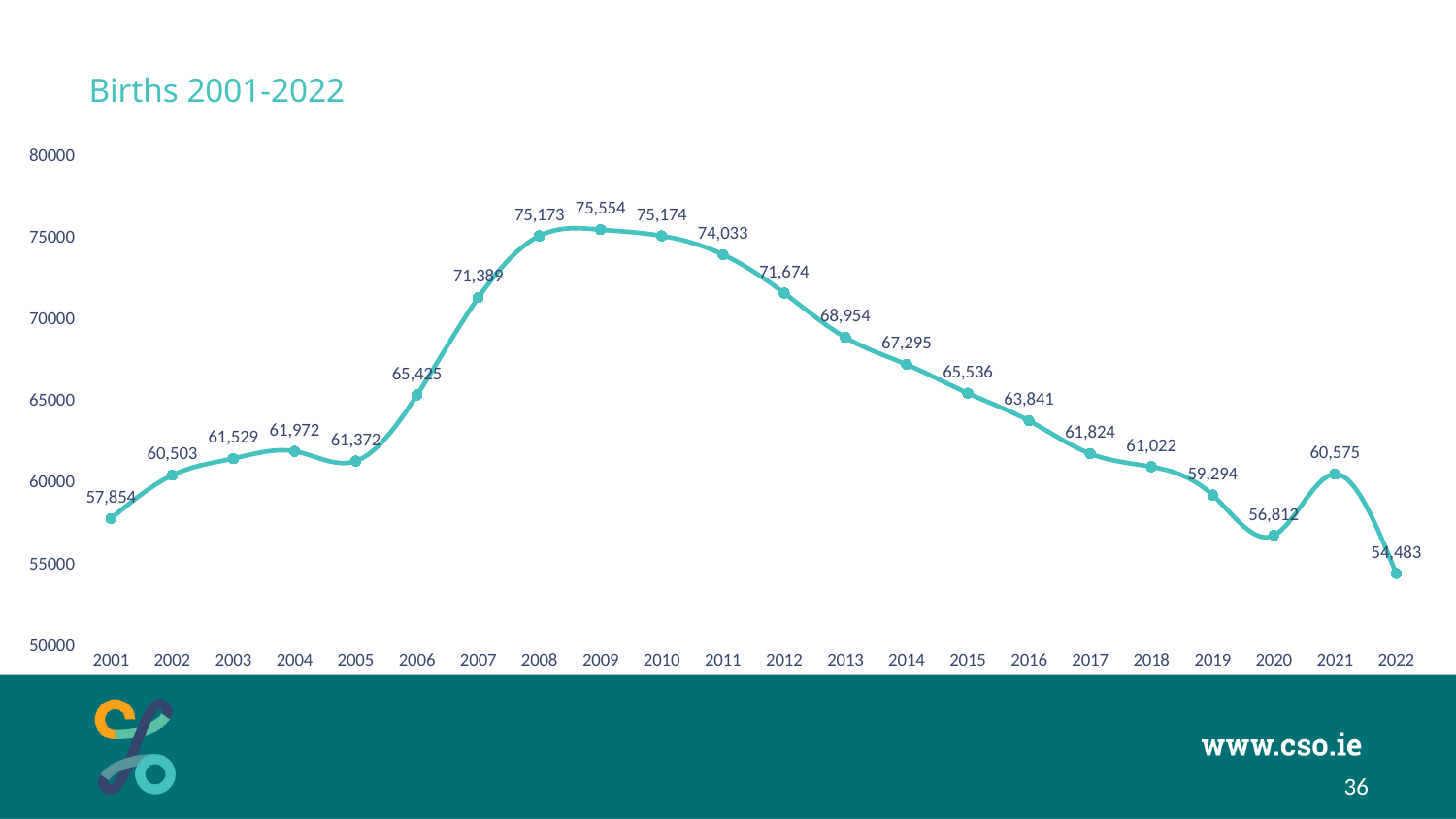
Which year has the lowest number of births? 2022 What is the difference between the values for 2021 and 2020? 3,763 What is the value for 2022? 54,483 Which year has the highest number of births? 2009 Is the value for 2007 greater or less than 70000? greater Which is larger, the value for 2013 or the value for 2016? 2013 What is the difference between the values for 2009 and 2022? 21,071 What is the value for 2015? 65,536 What is the value for 2009? 75,554 How many years are plotted on the chart? 22 What is the value for 2001? 57,854 What kind of chart is this? line chart